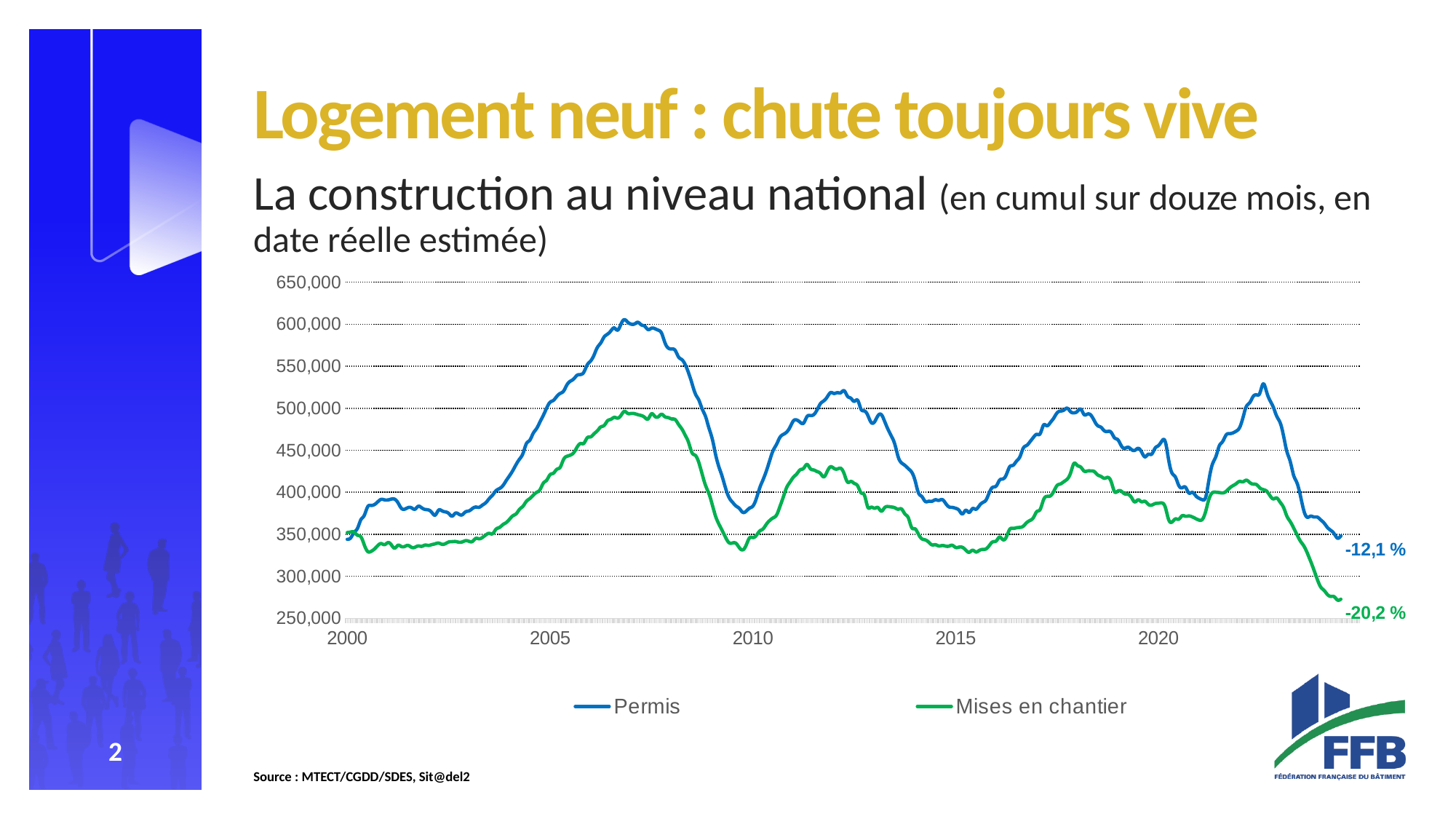
What is the highest value shown on the vertical axis? 650,000 Is the value of the Mises en chantier line at the right-hand end of the chart greater or less than 300,000? less Is the value of the Permis line at the right-hand end of the chart greater or less than 300,000? greater How many series does the legend list? 2 What are the two series named in the legend? Permis and Mises en chantier At the right-hand end of the chart, which series is higher, Permis or Mises en chantier? Permis Which series reaches the highest value anywhere on the chart, Permis or Mises en chantier? Permis What percentage change is annotated at the end of the Permis line? -12,1 % What percentage change is annotated at the end of the Mises en chantier line? -20,2 % From about 2022 to the end of the chart, do the Permis and Mises en chantier lines rise or fall? fall Is the peak value of the Permis line around 2007 greater or less than 550,000? greater What kind of chart is shown on the slide? line chart